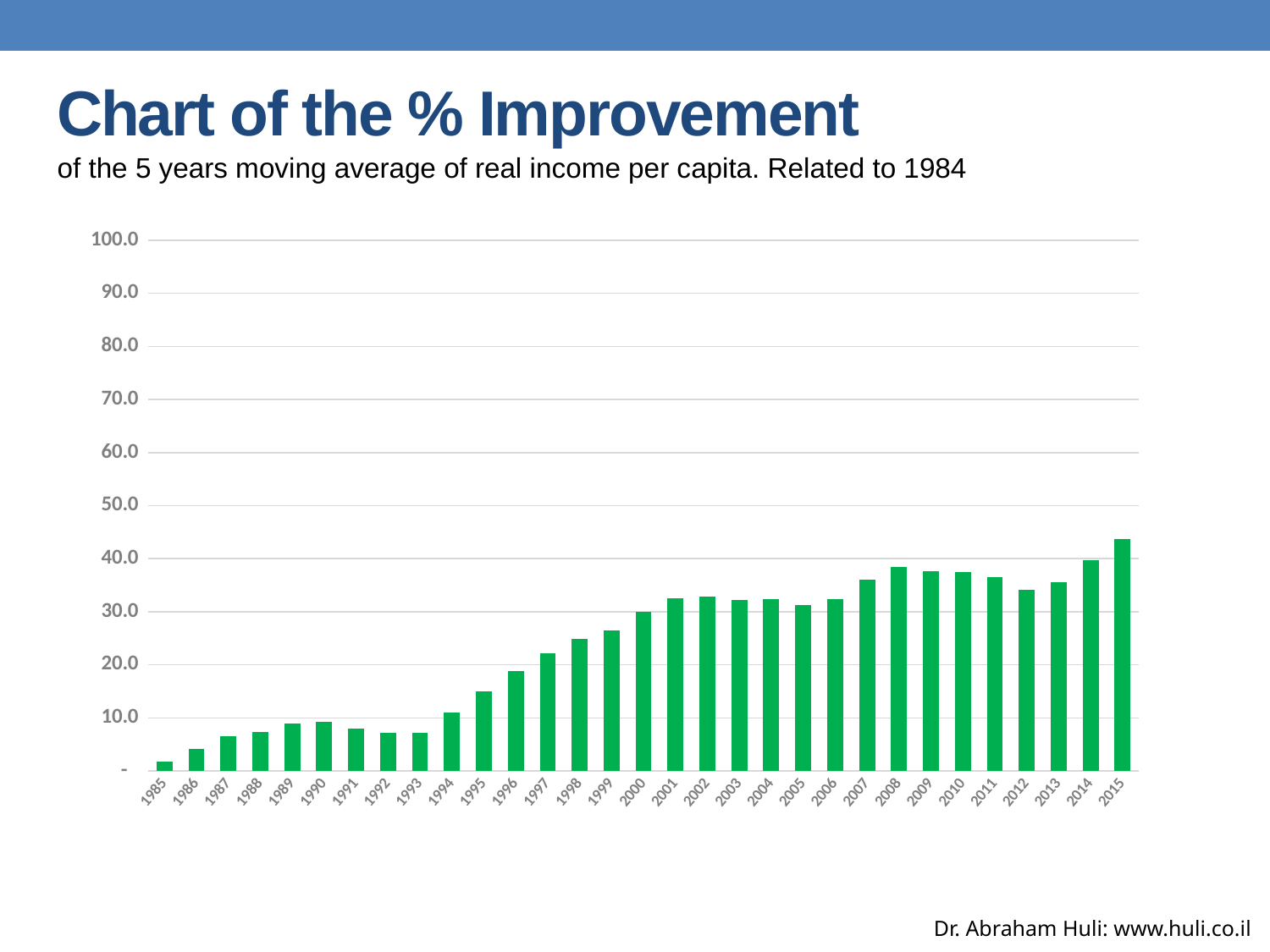
How many years (bars) are plotted on the chart? 31 What kind of chart is shown on the slide? bar chart Which year has the larger value, 2007 or 2000? 2007 Which year has the larger value, 1990 or 1985? 1990 Which year has the lowest value on the chart? 1985 Is the value for 1985 greater or less than 10? less Is the value for 1996 greater or less than 20? less Do the values generally rise or fall from 1985 to 2015? rise What is the title of the chart on the slide? Chart of the % Improvement Which year has the highest value on the chart? 2015 Is the value for 2008 greater or less than 30? greater